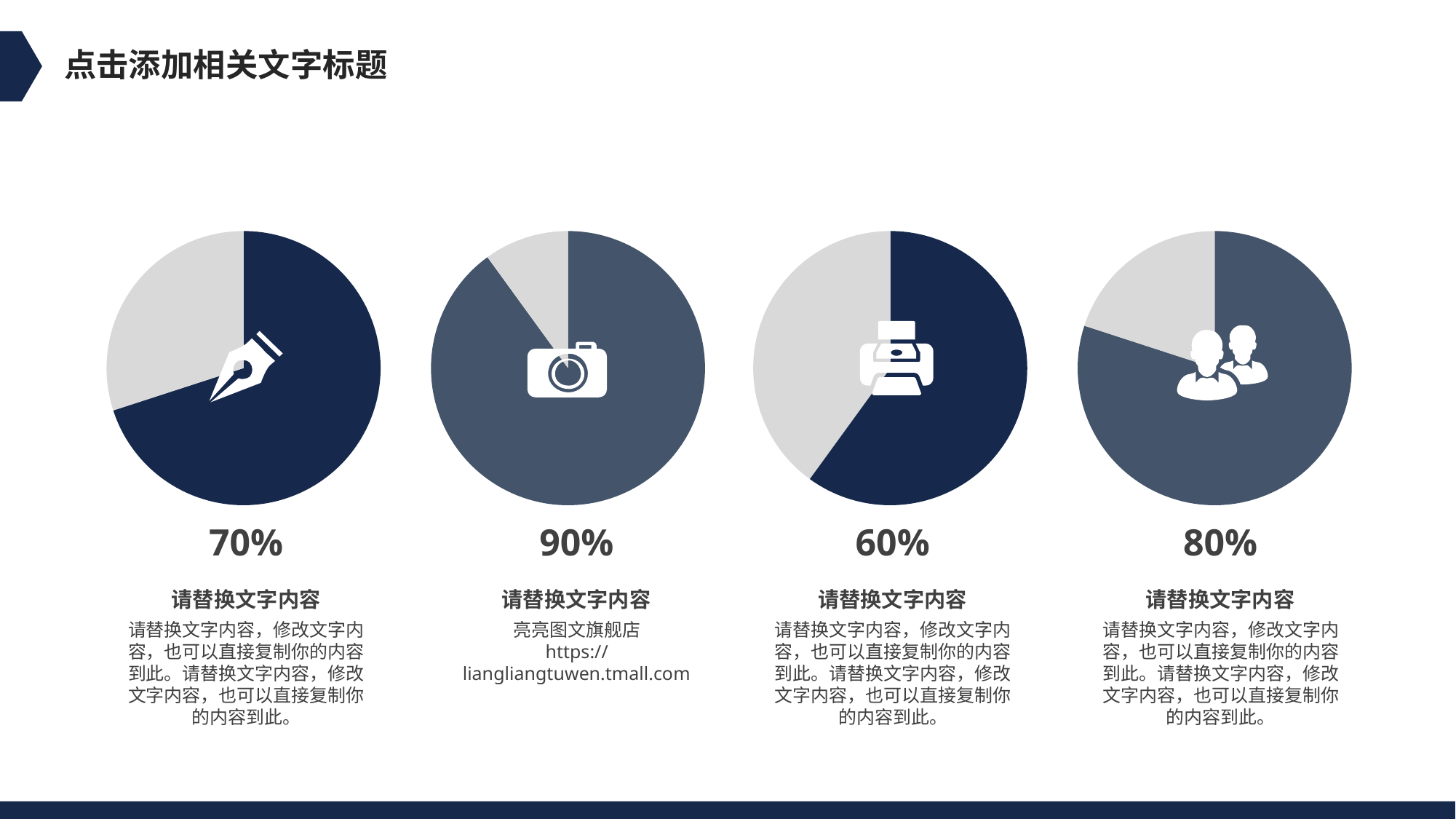
Which pie chart shows the lowest percentage? the third from the left (printer icon), 60% How many slices does each pie chart have? 2 How many pie charts are on the slide? 4 What percentage is shown below the third pie chart from the left (with the printer icon)? 60% What kind of charts are shown on the slide? pie charts Which pie chart shows the highest percentage? the second from the left (camera icon), 90% What is the difference between the percentage of the second pie chart (90%) and the third pie chart (60%)? 30% Which is larger, the percentage of the leftmost pie chart or the rightmost pie chart? the rightmost (80%) What percentage is shown below the second pie chart from the left (with the camera icon)? 90% What percentage is shown below the rightmost pie chart (with the people icon)? 80% In the leftmost pie chart, what share of the pie does the dark blue slice represent? 70% What percentage is shown below the leftmost pie chart (with the pen icon)? 70%